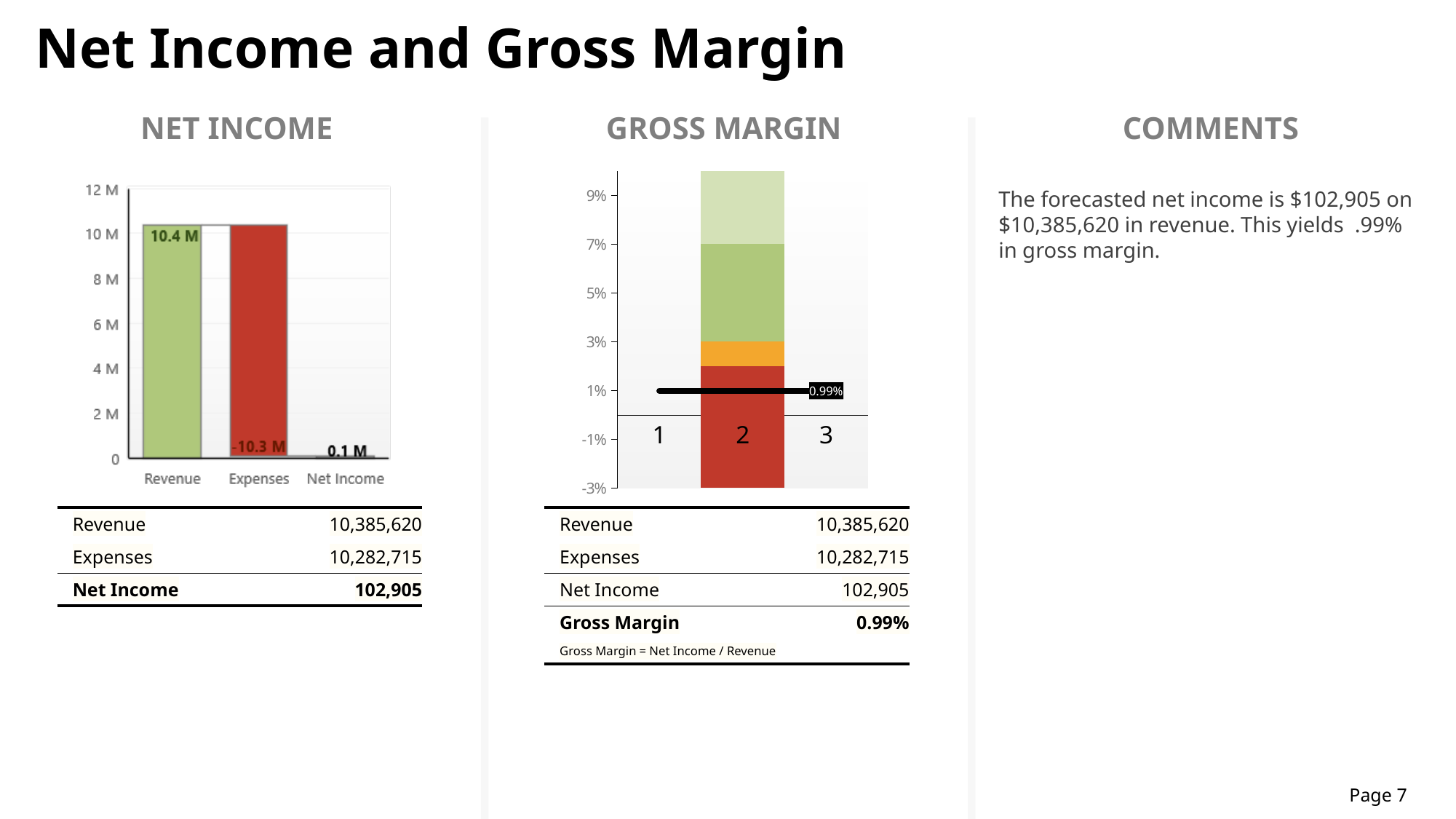
On the Net Income chart, which category has the highest value? Revenue On the Net Income chart, what is the data label on the Revenue bar? 10.4 M On the Net Income chart, is the value for Revenue greater or less than 10 M? greater On the Net Income chart, which category has the lowest value? Expenses On the Net Income chart, what is the difference between the Revenue label and the Net Income label? 10.3 M What is the title of the chart on the left of the slide? NET INCOME On the Net Income chart, what is the data label on the Expenses bar? -10.3 M What kind of chart is the Net Income chart? Bar chart On the Net Income chart, how many categories are shown on the x axis? 3 On the Gross Margin chart, what value is shown by the marker label? 0.99% On the Gross Margin chart, is the marked gross margin value greater or less than 1%? less On the Net Income chart, what is the data label on the Net Income bar? 0.1 M